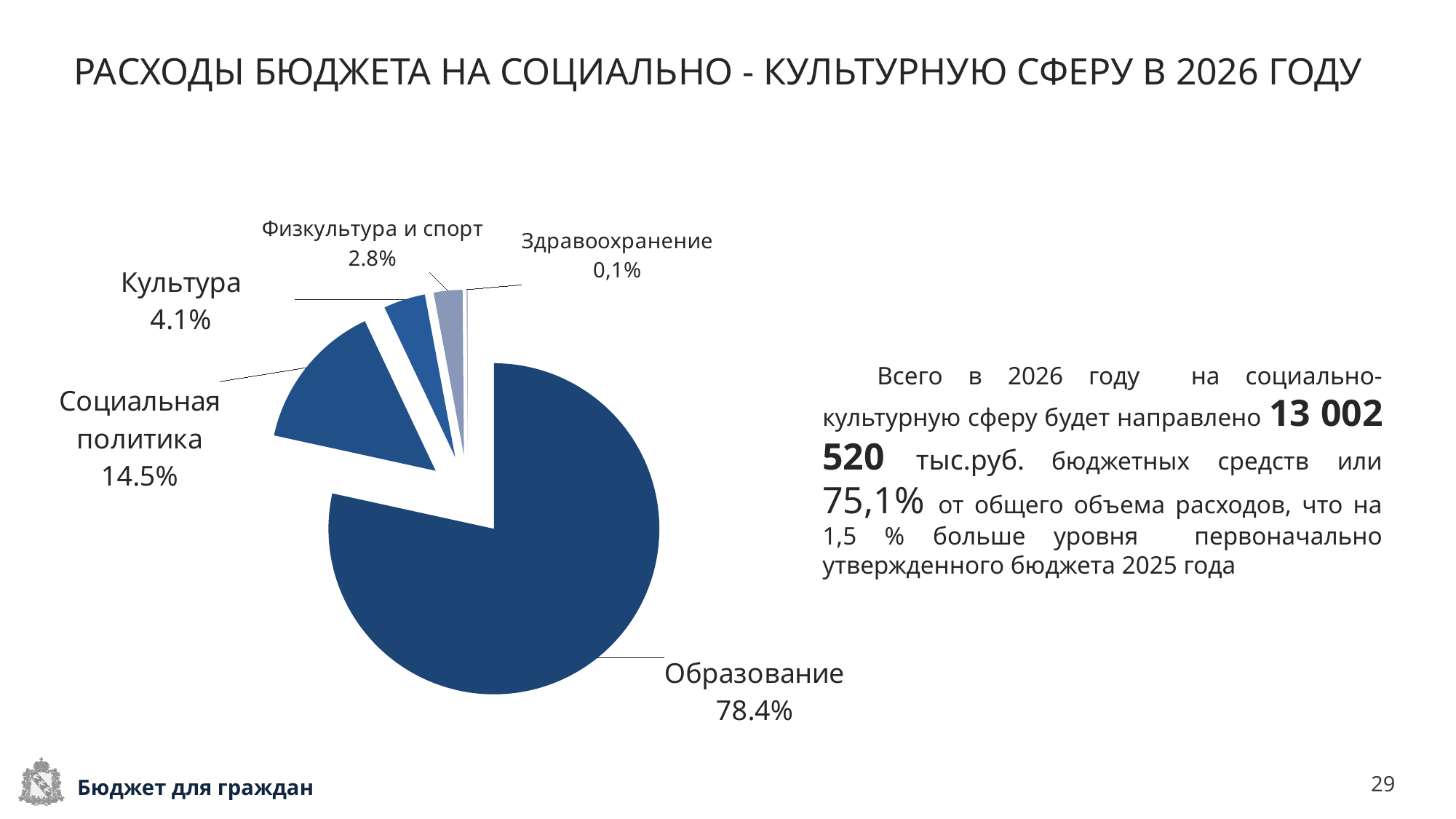
How many categories are shown in the pie chart? 5 What share of the pie does Образование have? 78.4% What kind of chart is shown on the slide? Pie chart What is the difference between the shares of Образование and Социальная политика? 63.9% What is the value shown for Культура? 4.1% Which category has the largest share of the pie? Образование What is the value shown for Социальная политика? 14.5% What is the value shown for Физкультура и спорт? 2.8% What is the title of the slide containing the chart? РАСХОДЫ БЮДЖЕТА НА СОЦИАЛЬНО - КУЛЬТУРНУЮ СФЕРУ В 2026 ГОДУ Which category has the smallest share of the pie? Здравоохранение What is the value shown for Здравоохранение? 0,1% Which is larger, the share for Культура or the share for Физкультура и спорт? Культура